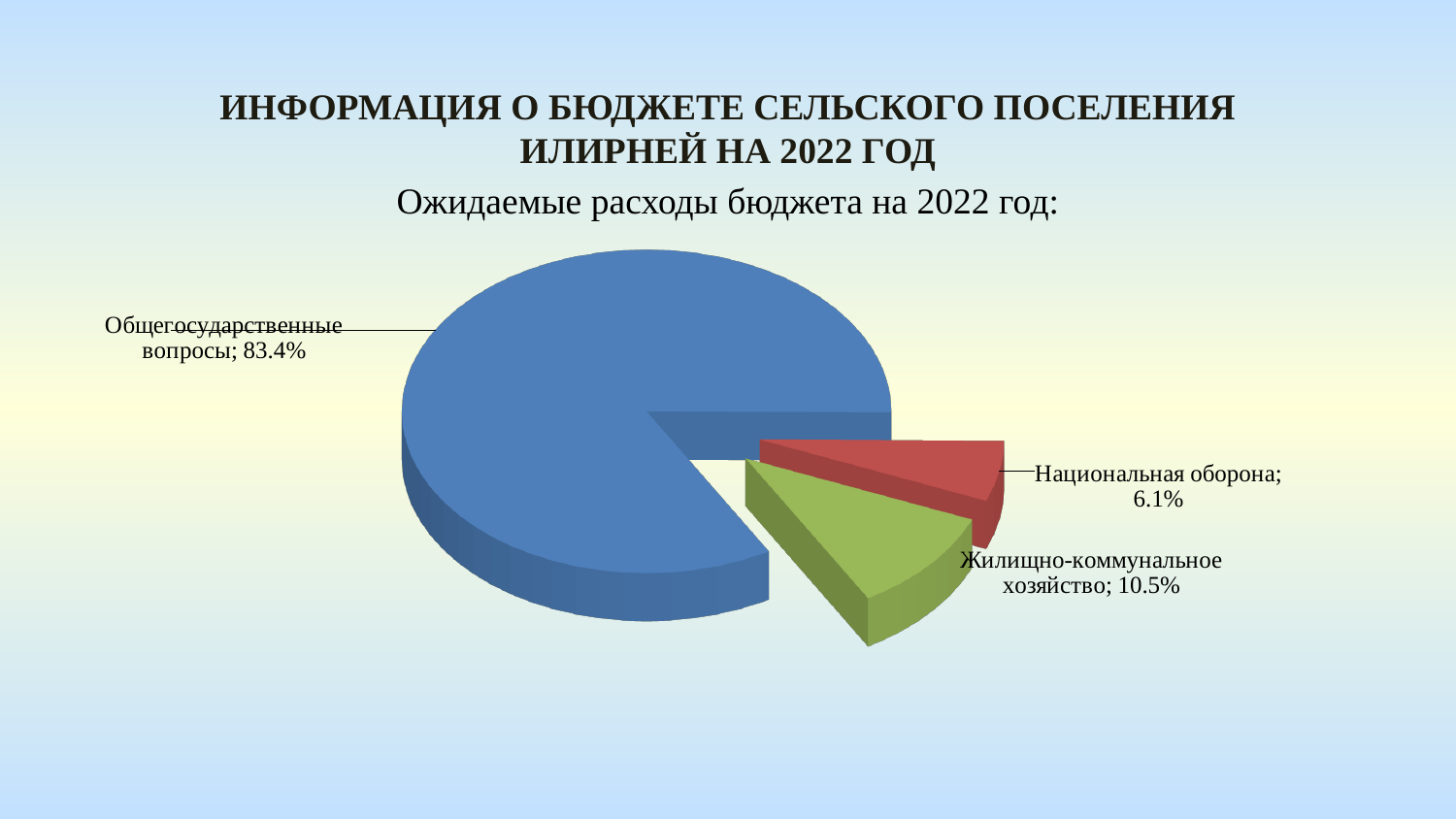
What colour is the slice for Национальная оборона? Red What is the difference in percentage points between Жилищно-коммунальное хозяйство and Национальная оборона? 4.4 What share of the pie does Общегосударственные вопросы represent? 83.4% Which category has the largest slice of the pie? Общегосударственные вопросы What is the difference in percentage points between Общегосударственные вопросы and Жилищно-коммунальное хозяйство? 72.9 Which category has the smallest slice of the pie? Национальная оборона Which is larger, the share for Жилищно-коммунальное хозяйство or the share for Национальная оборона? Жилищно-коммунальное хозяйство What share of the pie does Национальная оборона represent? 6.1% What share of the pie does Жилищно-коммунальное хозяйство represent? 10.5% How many categories are shown in the pie chart? 3 What is the subtitle above the chart? Ожидаемые расходы бюджета на 2022 год: What kind of chart is shown on the slide? Pie chart